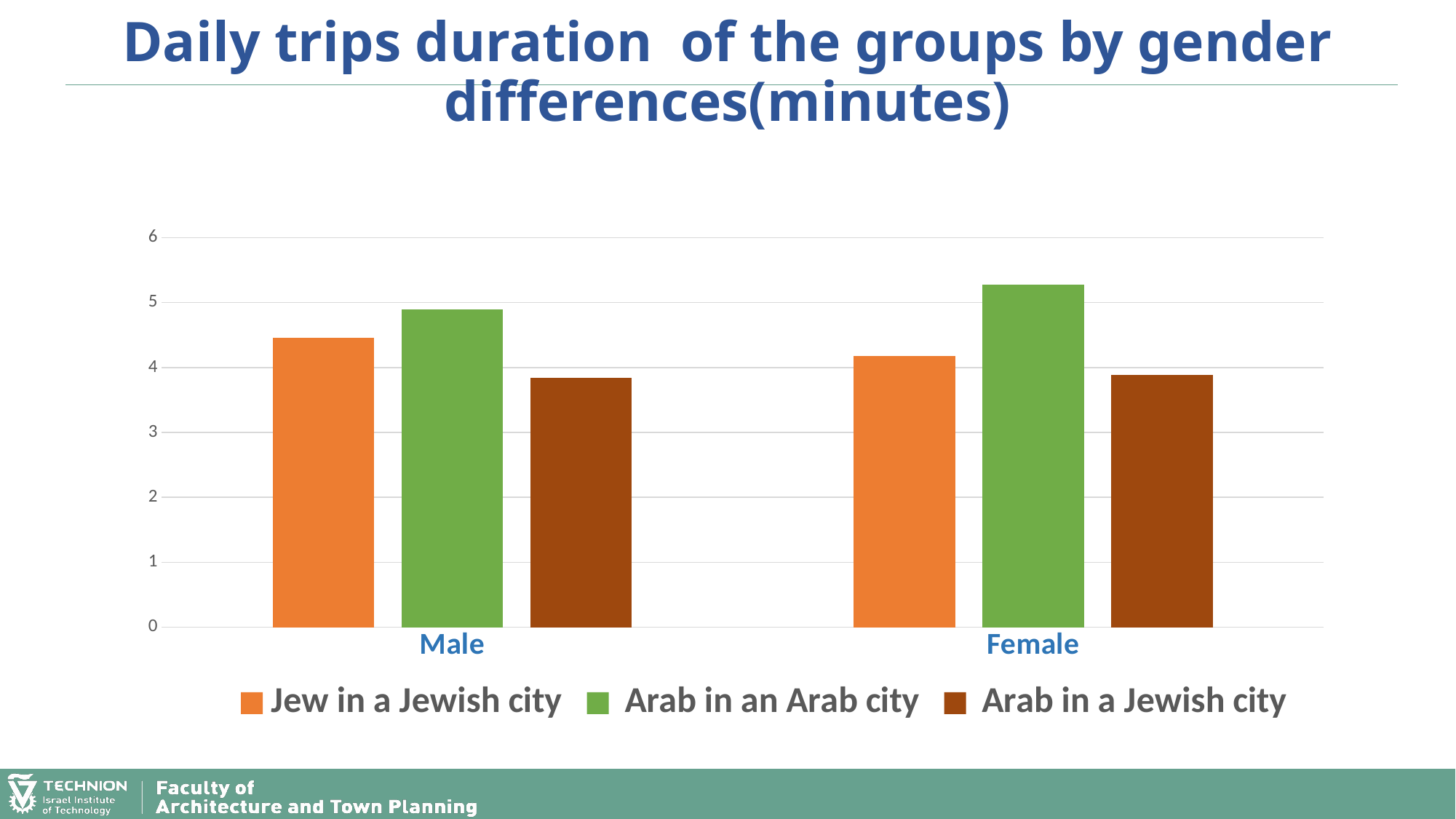
For Arab in an Arab city, which is larger: Male or Female? Female Which series has the lowest value for Male? Arab in a Jewish city What is the title of the chart? Daily trips duration of the groups by gender differences(minutes) How many categories are shown on the x axis? 2 Which series has the lowest value for Female? Arab in a Jewish city For Male, which is larger: Jew in a Jewish city or Arab in an Arab city? Arab in an Arab city What kind of chart is shown on the slide? bar chart Which series has the highest value for Female? Arab in an Arab city Is the value for Arab in an Arab city for Female greater or less than 5? greater For Jew in a Jewish city, which is larger: Male or Female? Male How many series does the legend list? 3 Is the value for Arab in a Jewish city for Male greater or less than 4? less